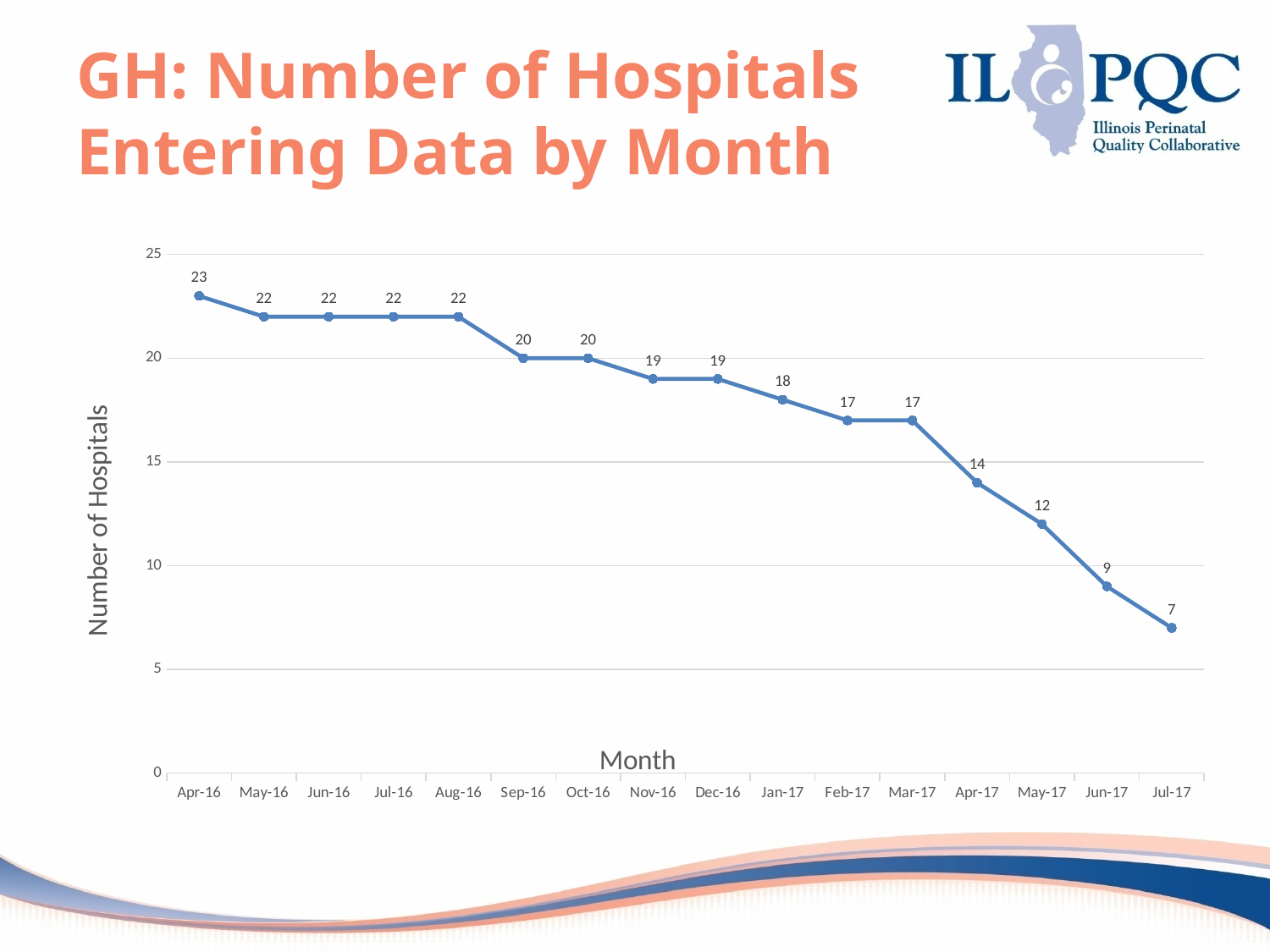
Which month has the highest number of hospitals entering data? Apr-16 What is the number of hospitals entering data in Apr-16? 23 How many months are plotted on the x axis? 16 What kind of chart is shown on the slide? Line chart What is the difference between the number of hospitals in Apr-16 and Jul-17? 16 What is the number of hospitals entering data in Jan-17? 18 What is the number of hospitals entering data in Jul-17? 7 Which month has more hospitals entering data, Sep-16 or Apr-17? Sep-16 Which month has the lowest number of hospitals entering data? Jul-17 What is the label of the y axis? Number of Hospitals Do the values rise or fall from Apr-16 to Jul-17? Fall Is the value for May-17 greater or less than 15? less